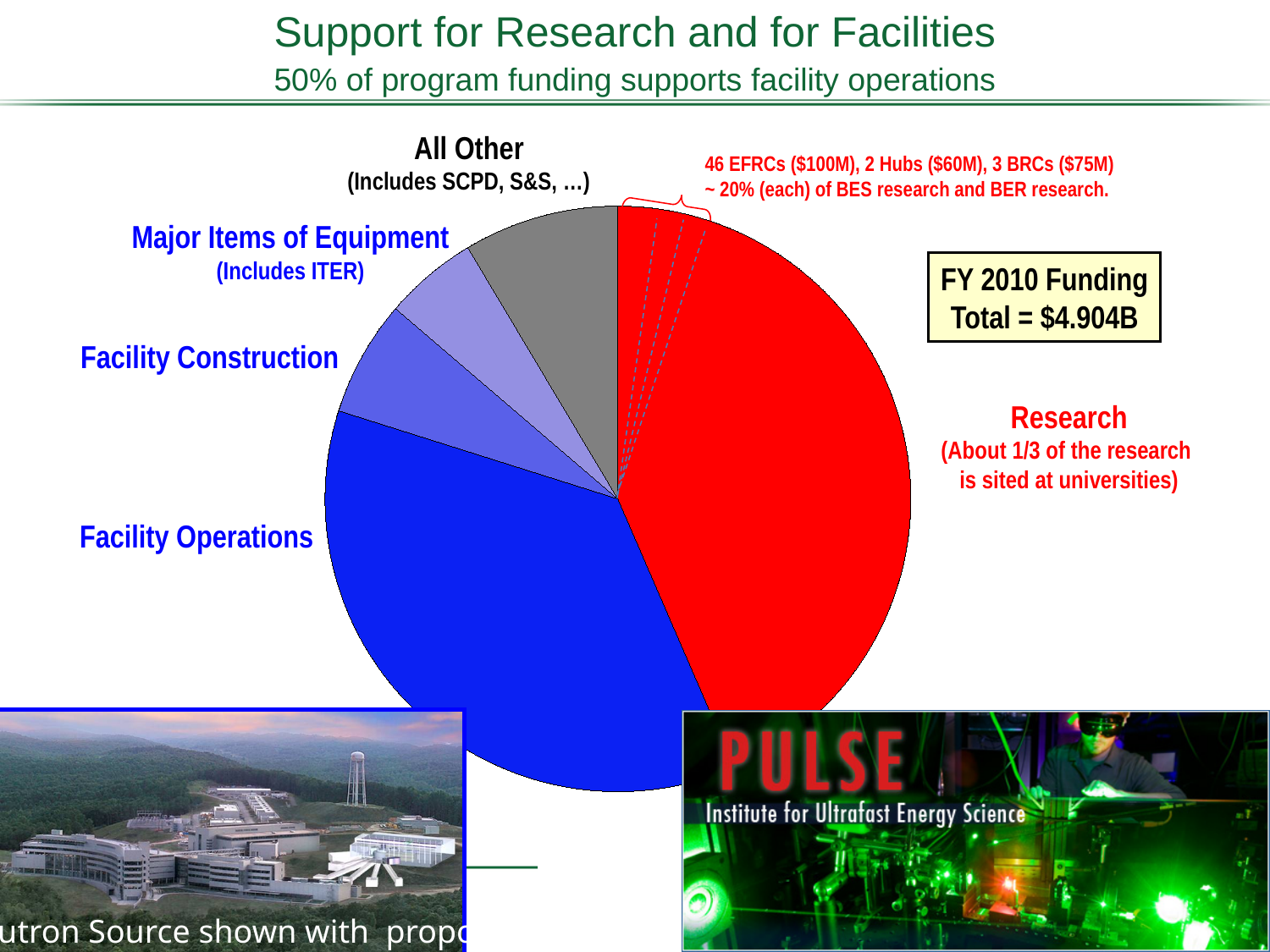
Which slice is larger, Facility Operations or Facility Construction? Facility Operations Which slice is larger, Facility Construction or All Other? All Other What is the title of the slide containing the pie chart? Support for Research and for Facilities What colour is the Research slice of the pie chart? red Which category has the smallest slice of the pie chart? Major Items of Equipment What is the FY 2010 funding total shown next to the pie chart? $4.904B Which slice is larger, Research or Facility Operations? Research Which category has the largest slice of the pie chart? Research How many slices does the pie chart have? 5 What kind of chart is shown on the slide? pie chart